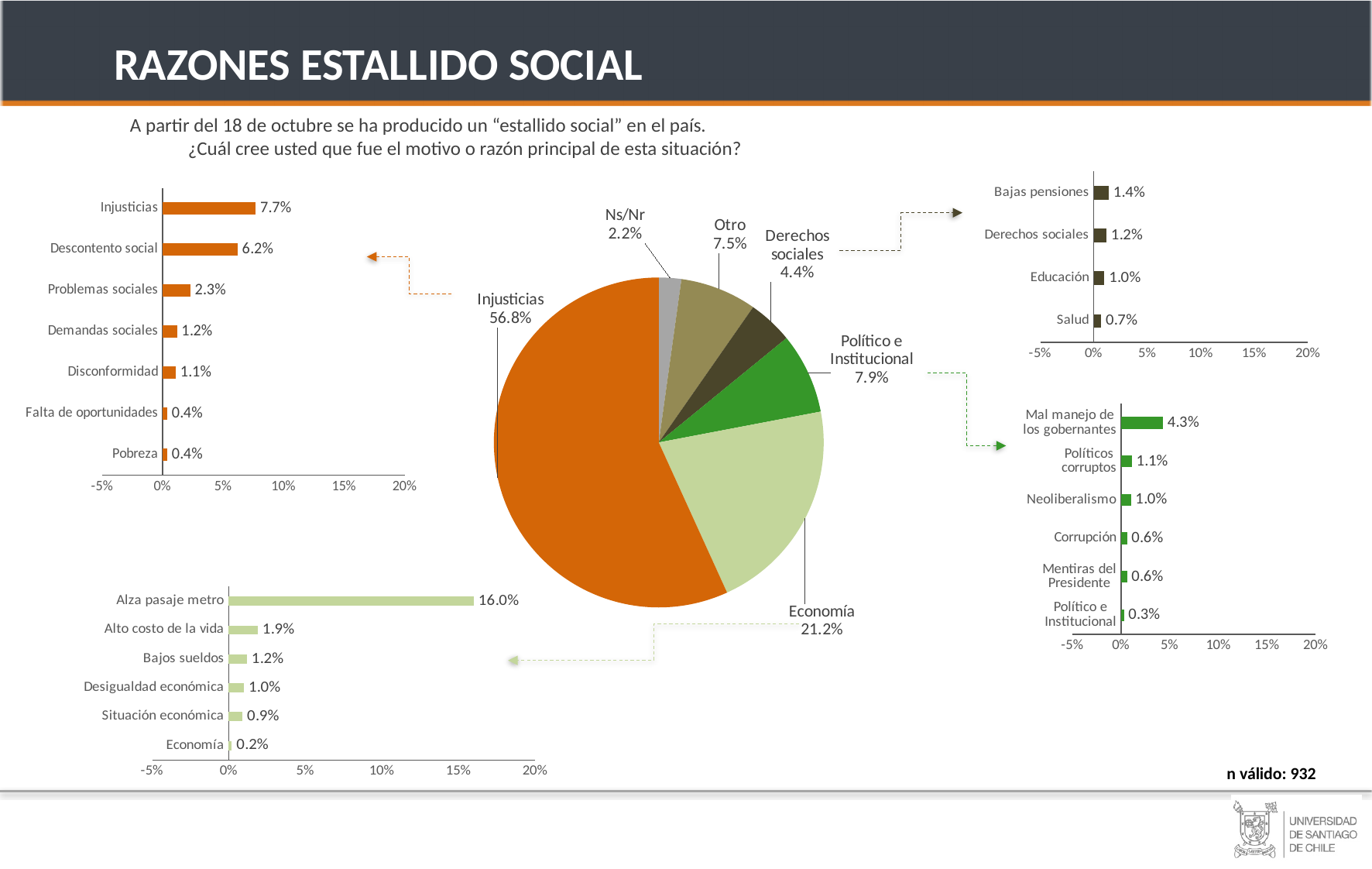
In the bottom-left bar chart, which is larger: Alto costo de la vida or Bajos sueldos? Alto costo de la vida How many categories are shown in the top-left bar chart? 7 In the top-left bar chart, which category has the highest value? Injusticias What kind of chart is the one in the bottom-right of the slide? Bar chart In the bottom-left bar chart, what is the value for Alza pasaje metro? 16.0% In the bottom-right bar chart, what is the difference between Mal manejo de los gobernantes and Políticos corruptos? 3.2% In the top-right bar chart, what is the value for Salud? 0.7% In the top-left bar chart, what is the value for Descontento social? 6.2% In the central pie chart, what share does the Injusticias slice have? 56.8% How many slices does the central pie chart have? 6 In the central pie chart, what is the difference between the Economía and Político e Institucional shares? 13.3% In the central pie chart, which slice is the smallest? Ns/Nr